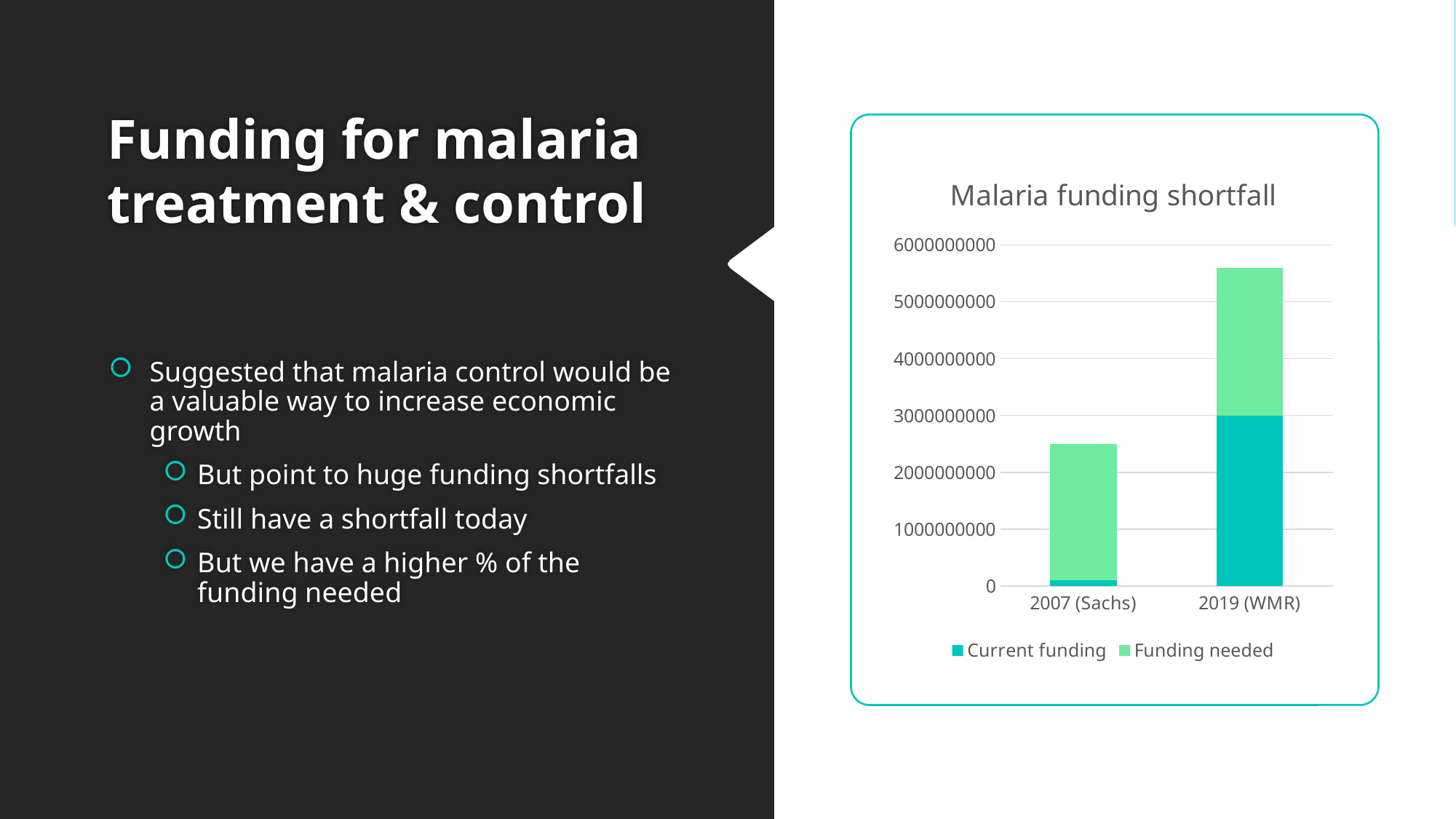
How many series does the legend list? 2 Is the total stacked bar for 2019 (WMR) greater or less than 5000000000? greater What kind of chart is shown on the slide? bar chart Which series is shown in the darker teal colour at the bottom of each bar? Current funding Is the total stacked bar for 2007 (Sachs) greater or less than 3000000000? less Do the total stacked bar heights rise or fall from 2007 (Sachs) to 2019 (WMR)? rise Is the Current funding value for 2019 (WMR) greater or less than 2000000000? greater Which category has the taller total stacked bar, 2007 (Sachs) or 2019 (WMR)? 2019 (WMR) Which category has the larger Current funding value? 2019 (WMR) How many categories are shown on the x axis? 2 What is the title of the chart? Malaria funding shortfall